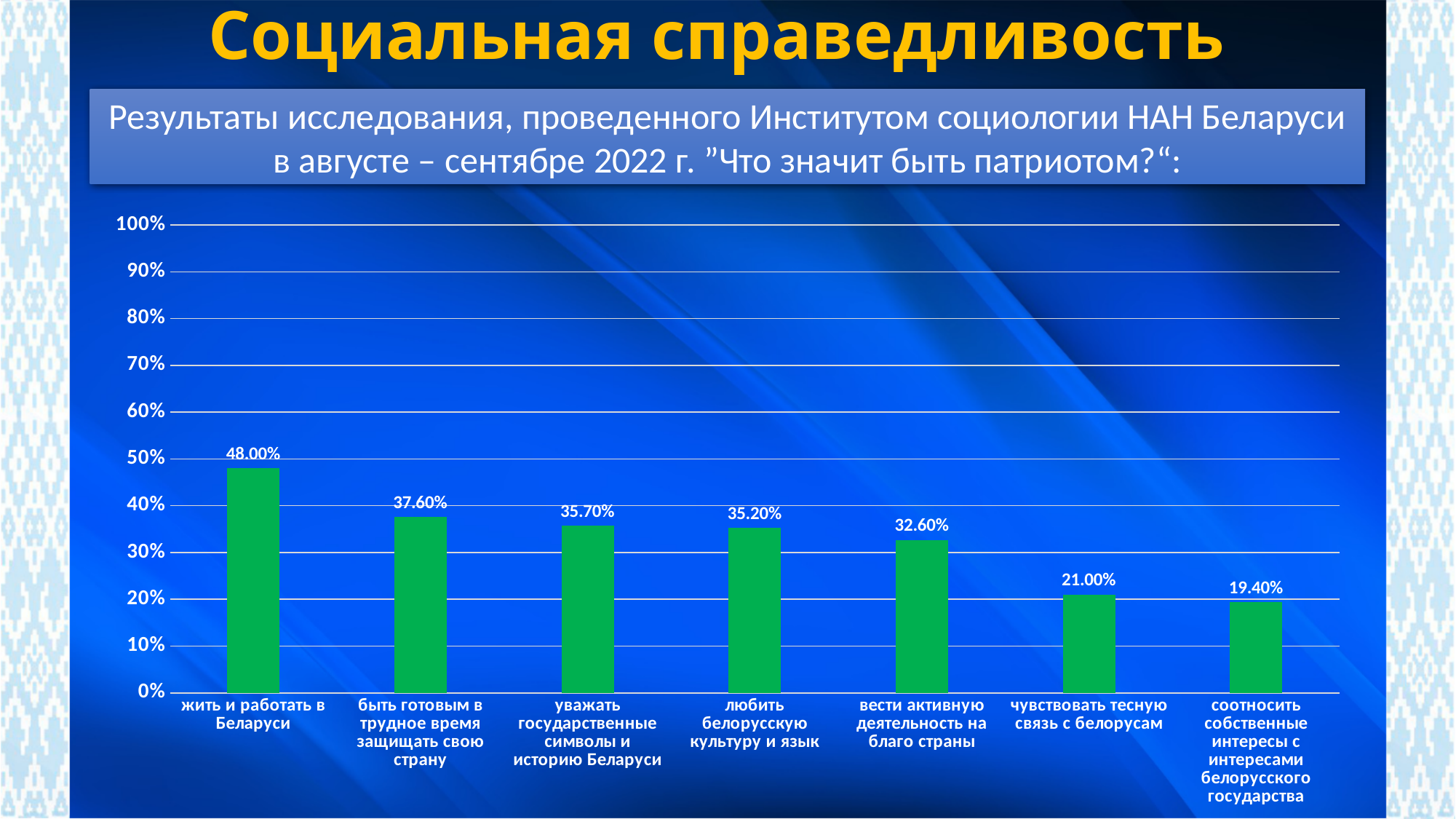
What kind of chart is shown on the slide? bar chart Which category has the lowest value? соотносить собственные интересы с интересами белорусского государства Which is larger: the value for "вести активную деятельность на благо страны" or the value for "чувствовать тесную связь с белорусам"? вести активную деятельность на благо страны Which category has the highest value? жить и работать в Беларуси What is the value for "любить белорусскую культуру и язык"? 35.20% Is the value for "уважать государственные символы и историю Беларуси" greater or less than 30%? greater What is the difference between the values for "жить и работать в Беларуси" and "быть готовым в трудное время защищать свою страну"? 10.40% What is the value for "жить и работать в Беларуси"? 48.00% What colour are the bars in the chart? green How many categories are shown in the chart? 7 What is the value for "соотносить собственные интересы с интересами белорусского государства"? 19.40% Do the values rise or fall from left to right across the categories? fall